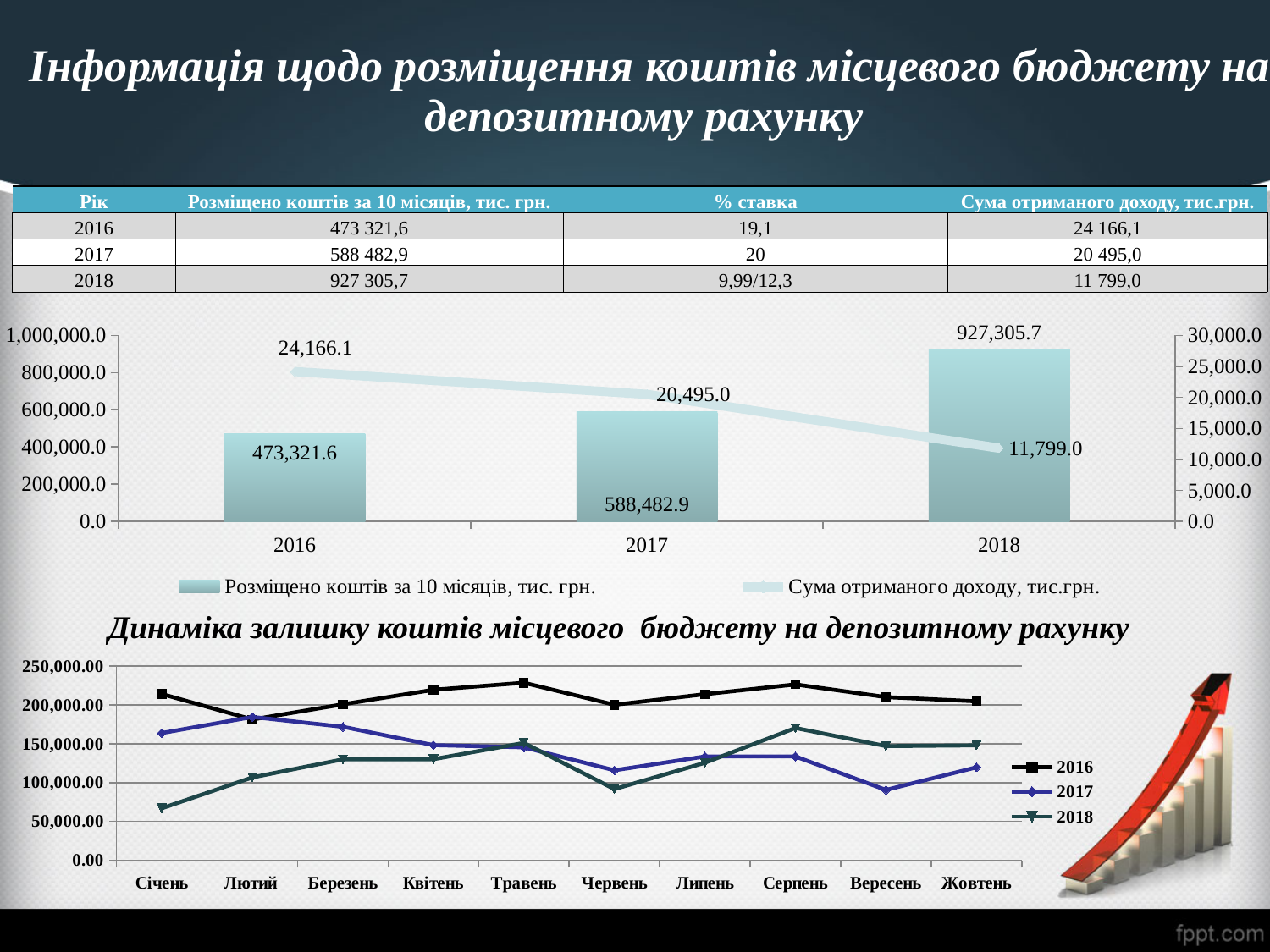
In the bottom chart, which series has the highest value in Січень? 2016 How many series does the legend of the bottom chart 'Динаміка залишку коштів місцевого бюджету на депозитному рахунку' list? 3 In the bottom chart, is the value for 2018 in Січень greater or less than 100,000.00? less In the top chart, does 'Сума отриманого доходу, тис.грн.' rise or fall from 2016 to 2018? fall In the top chart, which year has the lowest 'Сума отриманого доходу, тис.грн.'? 2018 In the top chart, what is the value of 'Розміщено коштів за 10 місяців, тис. грн.' for 2018? 927,305.7 In the top chart, what is the value of 'Сума отриманого доходу, тис.грн.' for 2017? 20,495.0 In the top chart, which year has the highest 'Розміщено коштів за 10 місяців, тис. грн.'? 2018 How many months are shown on the x axis of the bottom chart 'Динаміка залишку коштів місцевого бюджету на депозитному рахунку'? 10 In the top chart, what is the difference between 'Розміщено коштів за 10 місяців' in 2018 and in 2017? 338,822.8 In the top chart, what is the difference between 'Сума отриманого доходу' in 2016 and in 2018? 12,367.1 In the bottom chart, is the value for 2016 in Травень greater or less than 200,000.00? greater